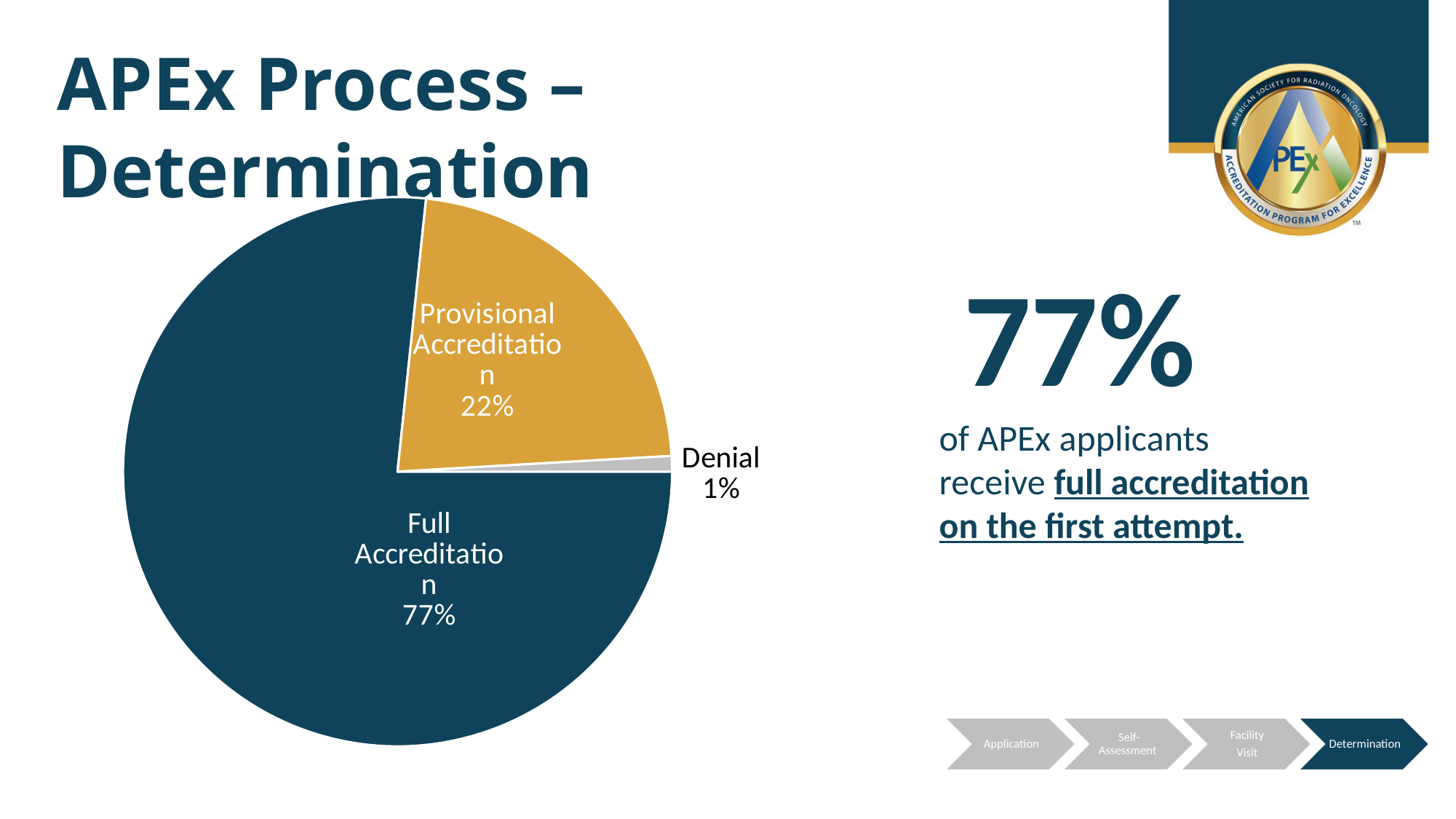
What is the combined share of Provisional Accreditation and Denial? 23% What is the difference in percentage points between Full Accreditation and Provisional Accreditation? 55 What percentage of the pie chart is Provisional Accreditation? 22% How many categories are shown in the pie chart? 3 What colour is the Full Accreditation slice? Dark blue What kind of chart is shown on the slide? Pie chart Which is larger, the Provisional Accreditation slice or the Denial slice? Provisional Accreditation What colour is the Provisional Accreditation slice? Gold What percentage of the pie chart is Denial? 1% Which category has the largest slice of the pie chart? Full Accreditation What percentage of the pie chart is Full Accreditation? 77% Which category has the smallest slice of the pie chart? Denial